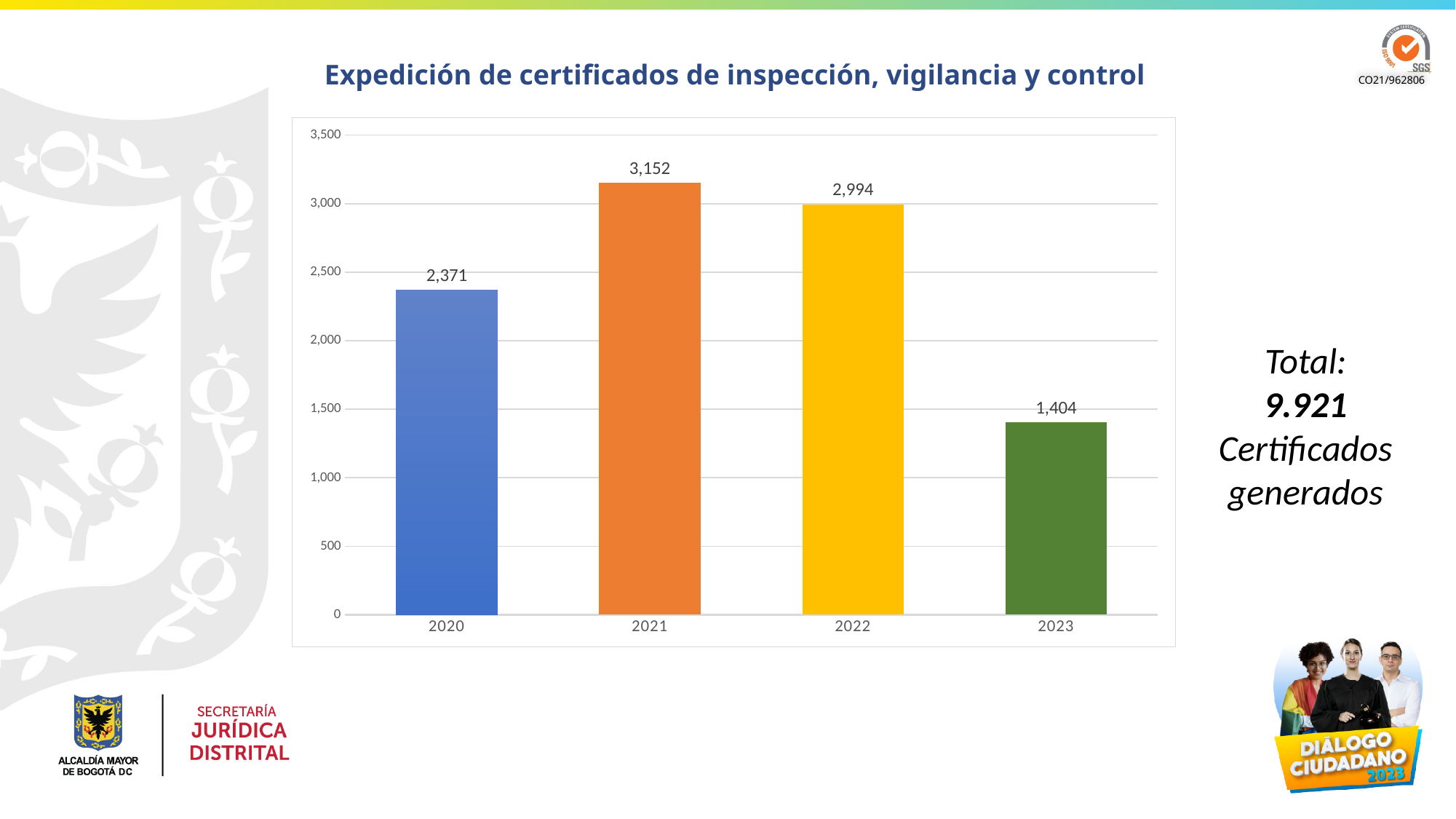
What is the value for 2023? 1,404 Which is larger, the value for 2020 or the value for 2022? 2022 What is the value for 2022? 2,994 Which year has the highest value? 2021 How many years are shown on the x axis? 4 Which year has the lowest value? 2023 What is the value for 2021? 3,152 What kind of chart is shown on the slide? Bar chart What is the difference between the values for 2021 and 2022? 158 What is the value for 2020? 2,371 What is the difference between the values for 2020 and 2023? 967 What is the title of the chart? Expedición de certificados de inspección, vigilancia y control